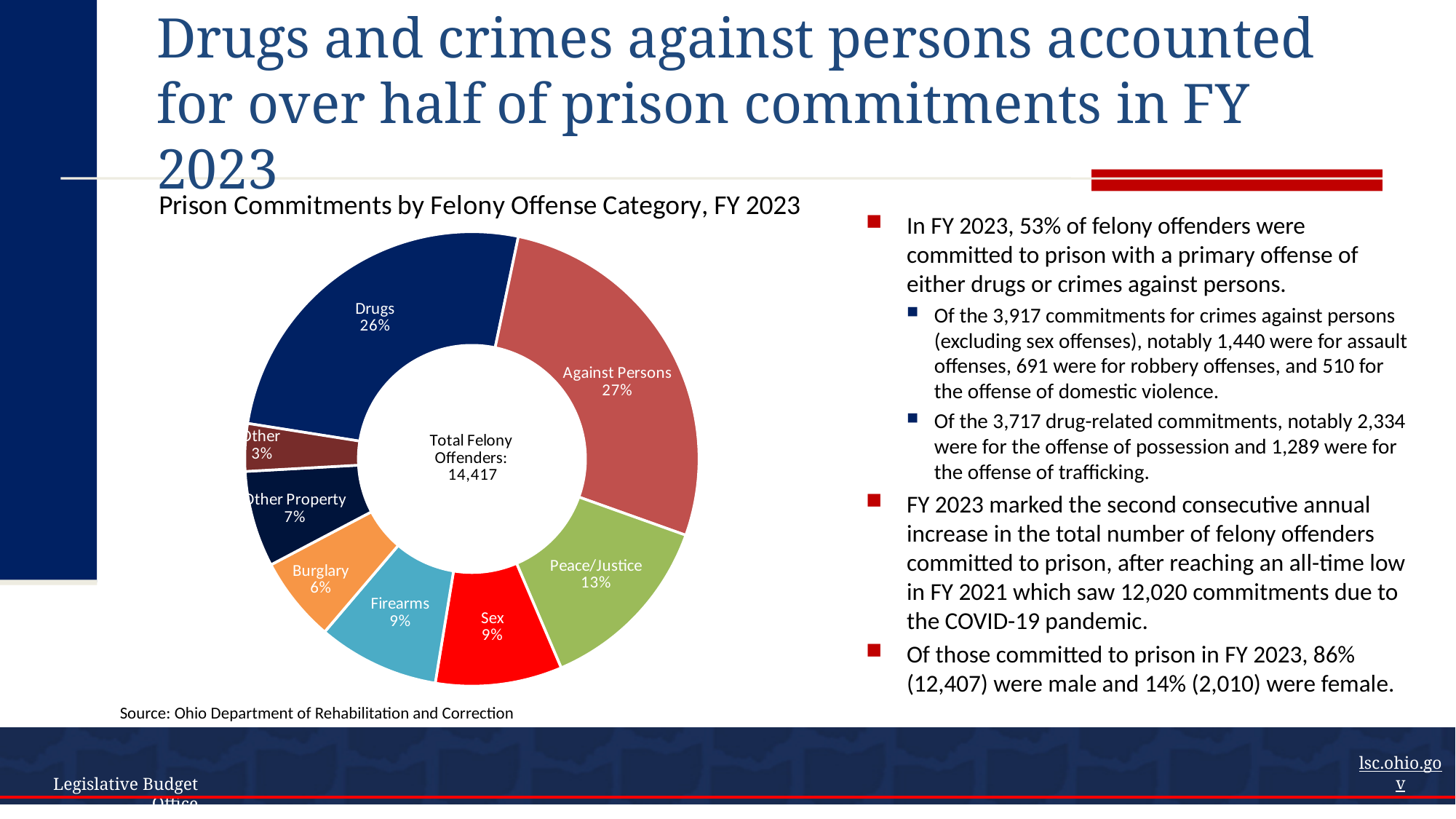
What share of prison commitments is for Burglary? 6% What type of chart is shown on the slide? Pie chart (doughnut) What share of prison commitments is for Drugs? 26% Which has a larger share, Peace/Justice or Firearms? Peace/Justice What share of prison commitments is for Peace/Justice? 13% What is the difference in percentage points between the Drugs share and the Other Property share? 19 percentage points What is the title of the chart? Prison Commitments by Felony Offense Category, FY 2023 How many offense categories are shown in the chart? 8 Which offense category has the smallest share of prison commitments? Other Which offense category has the largest share of prison commitments? Against Persons What is the total number of felony offenders shown in the center of the chart? 14,417